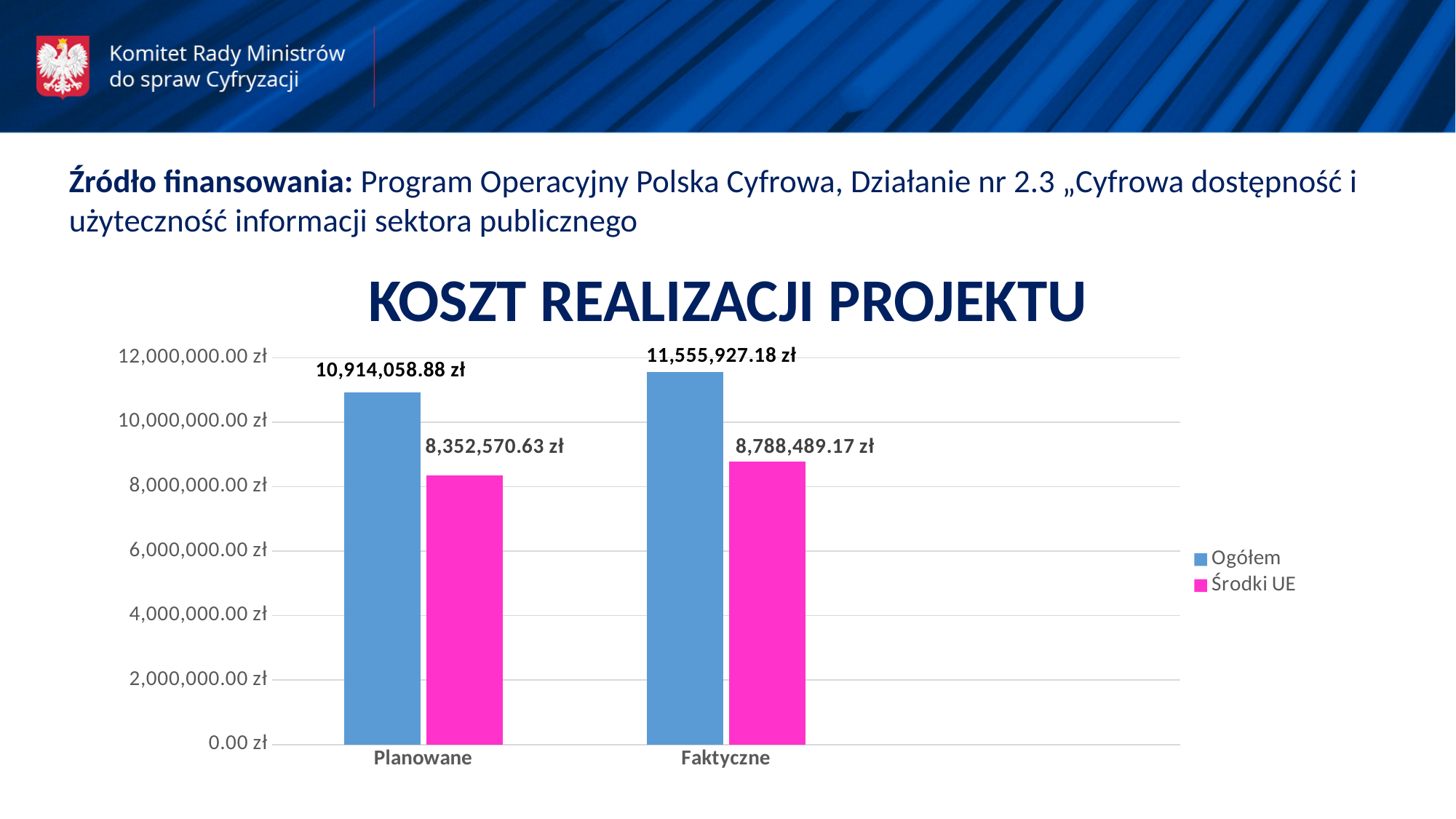
What type of chart is shown on the slide? bar chart How many categories are shown on the x axis? 2 Which category has the higher Ogółem value, Planowane or Faktyczne? Faktyczne What is the Środki UE value for Faktyczne? 8,788,489.17 zł How many series does the legend list? 2 What is the difference between Ogółem and Środki UE for Planowane? 2,561,488.25 zł Which bar is the lowest in the chart? Środki UE for Planowane What is the difference between the Ogółem values for Faktyczne and Planowane? 641,868.30 zł What is the Ogółem value for Faktyczne? 11,555,927.18 zł What is the title of the chart? KOSZT REALIZACJI PROJEKTU Is the Środki UE value for Faktyczne greater or less than 10,000,000.00 zł? less What is the Ogółem value for Planowane? 10,914,058.88 zł